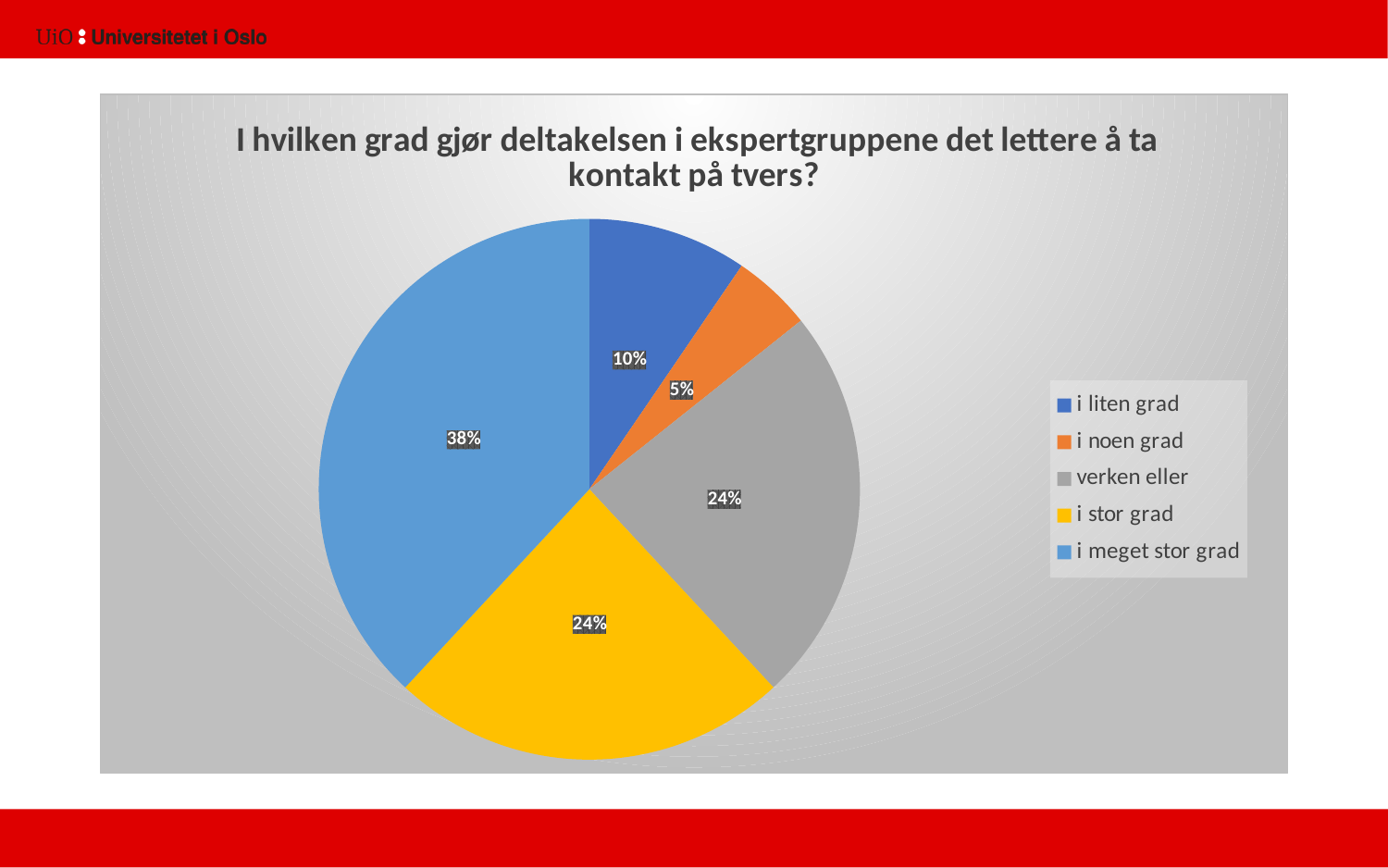
What share of the pie is labelled "i stor grad"? 24% What is the difference in percentage points between "i meget stor grad" and "i liten grad"? 28 Which category has the largest slice of the pie? i meget stor grad What share of the pie is labelled "i meget stor grad"? 38% What colour is the slice for "i stor grad"? yellow What share of the pie is labelled "i liten grad"? 10% What kind of chart is shown on the slide? pie chart Which is larger, the slice for "i liten grad" or the slice for "i noen grad"? i liten grad How many categories does the legend list? 5 Which category has the smallest slice of the pie? i noen grad